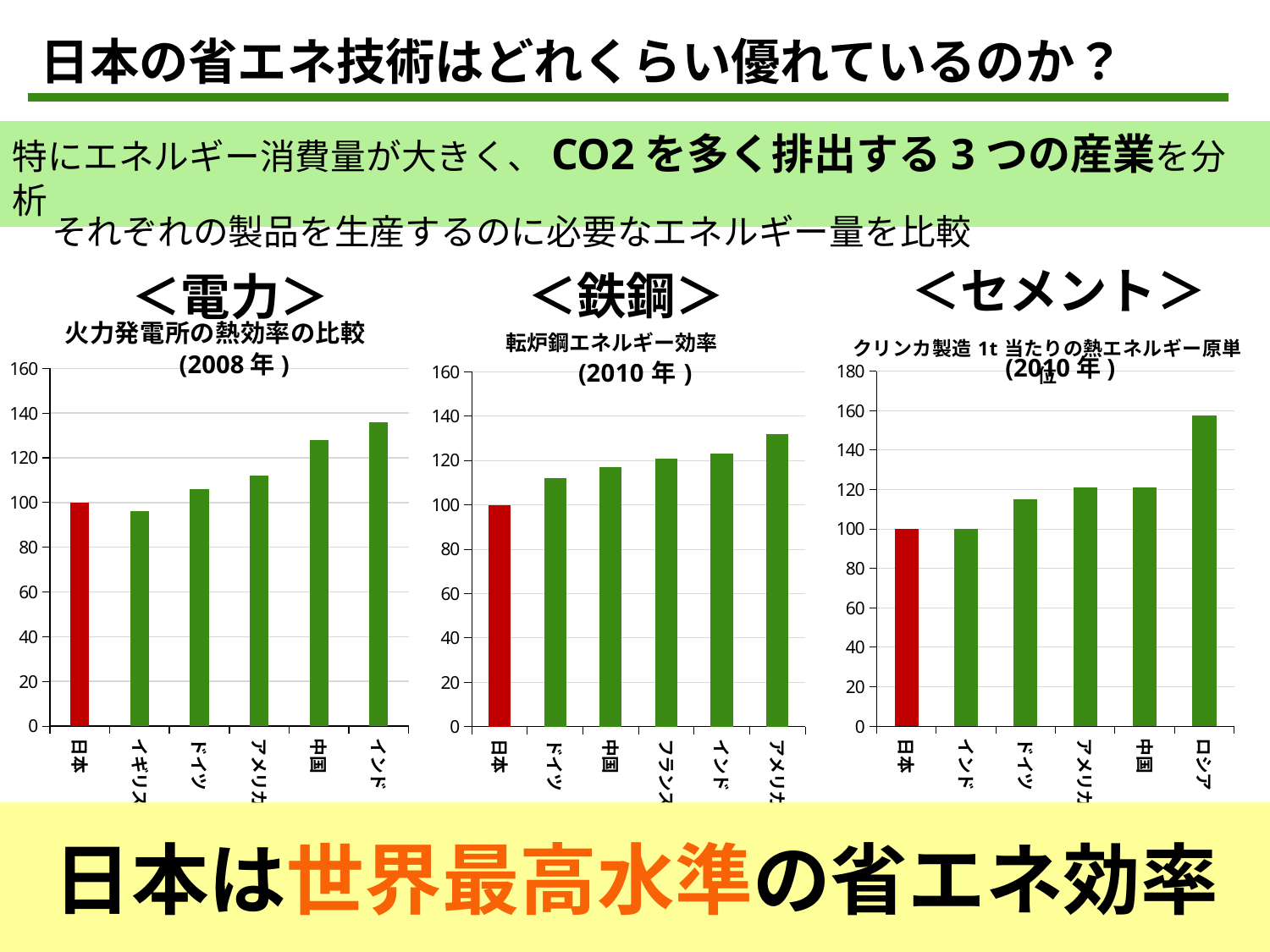
In the <セメント> chart on the right, what colour is the bar for 日本? red In the <電力> chart on the left, is the value for 中国 greater or less than 120? greater In the <鉄鋼> chart in the middle, is the value for ドイツ greater or less than 120? less In the <セメント> chart on the right, which is larger, the value for ドイツ or the value for ロシア? ロシア In the <電力> chart on the left, how many countries are shown? 6 In the <鉄鋼> chart in the middle, which country has the lowest value? 日本 In the <セメント> chart on the right, which country has the highest value? ロシア What kind of chart is the <電力> chart on the left? bar chart In the <電力> chart on the left, which country has the highest value? インド In the <鉄鋼> chart in the middle, which country has the highest value? アメリカ In the <電力> chart on the left, which country has the lowest value? イギリス In the <電力> chart on the left, what is the value for 日本? 100